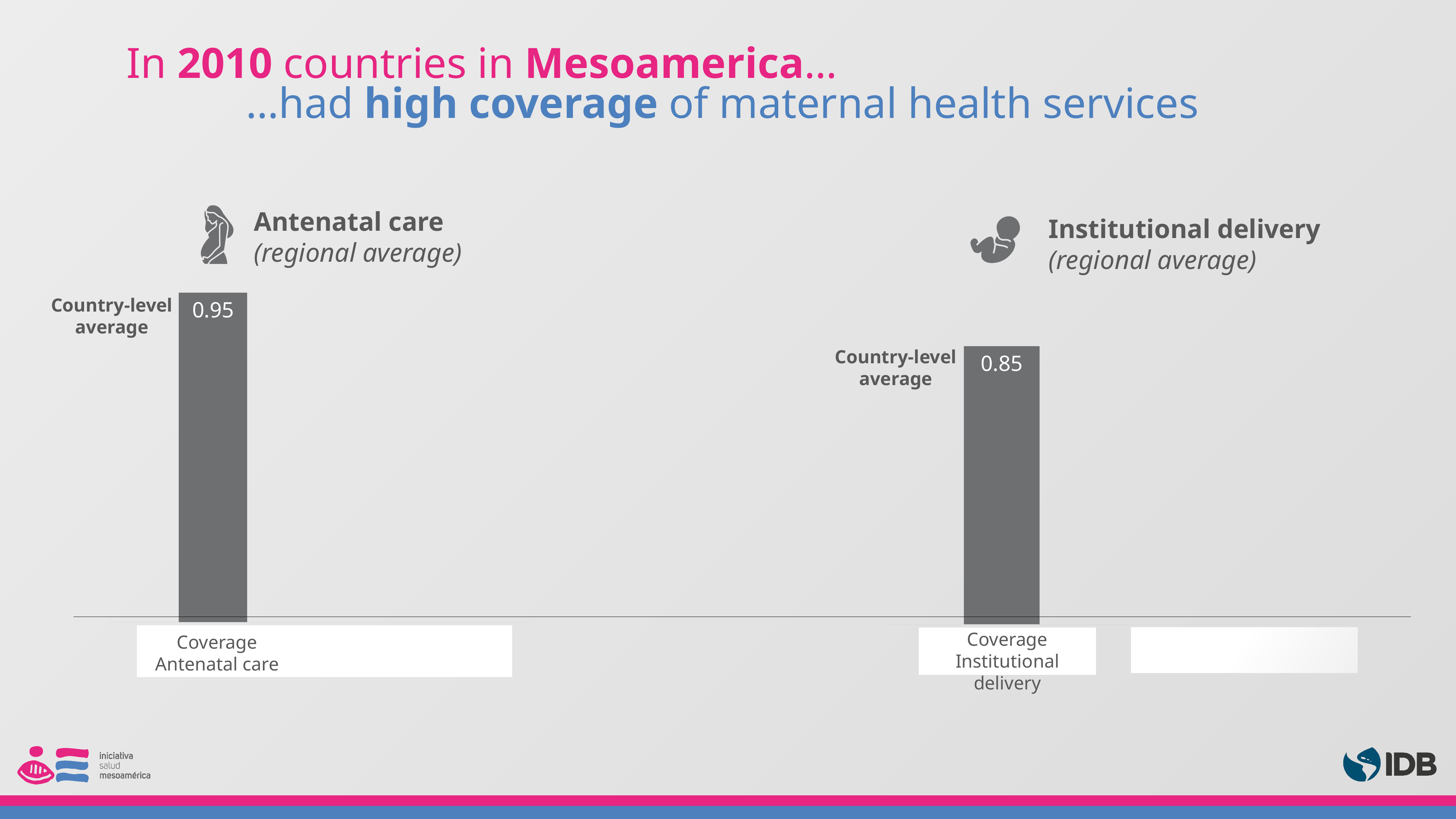
Which of the two coverage bars shows the highest value? Antenatal care What is the country-level average coverage for Institutional delivery? 0.85 What kind of chart is used to show the coverage values? Bar chart What year do the coverage values on the slide refer to? 2010 What is the difference between the Antenatal care coverage and the Institutional delivery coverage? 0.10 What colour are the coverage bars on the slide? Grey How many coverage bars are plotted on the slide? 2 What is the country-level average coverage for Antenatal care? 0.95 Which has the higher coverage value, Antenatal care or Institutional delivery? Antenatal care Which of the two coverage bars shows the lowest value? Institutional delivery